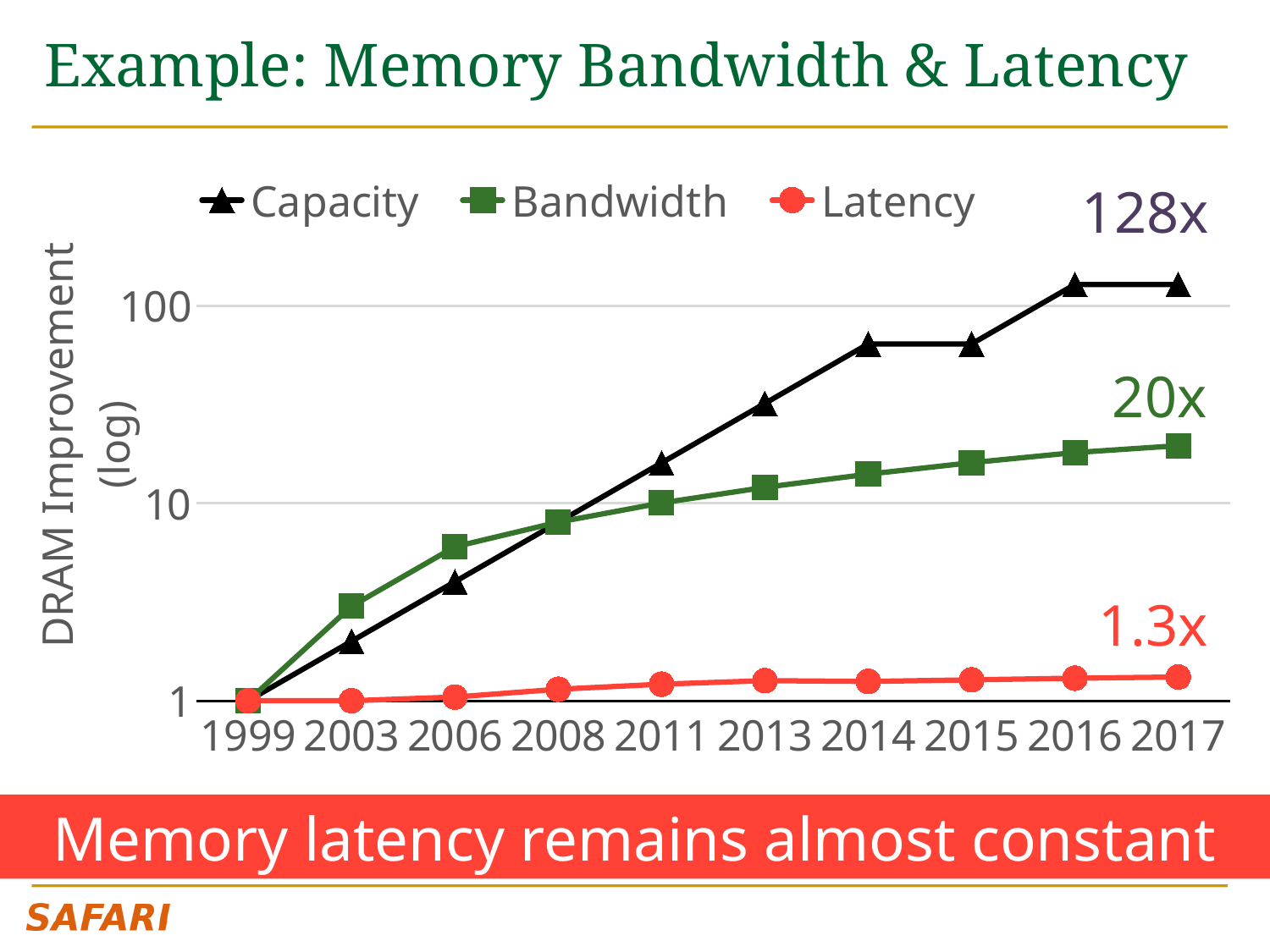
What kind of chart is shown on the slide? line chart Does the Capacity series rise or fall from 1999 to 2017? rise What is the Latency improvement in 2017? 1.3x Is the Capacity value for 2016 greater or less than 100? greater How many series does the legend list? 3 Which series has the lowest value in 2017? Latency In 2003, which is larger: Bandwidth or Capacity? Bandwidth What is the label of the y axis? DRAM Improvement (log) What is the Capacity improvement in 2017? 128x What is the Bandwidth improvement in 2017? 20x How many years are shown on the x axis? 10 Which series has the highest value in 2017? Capacity